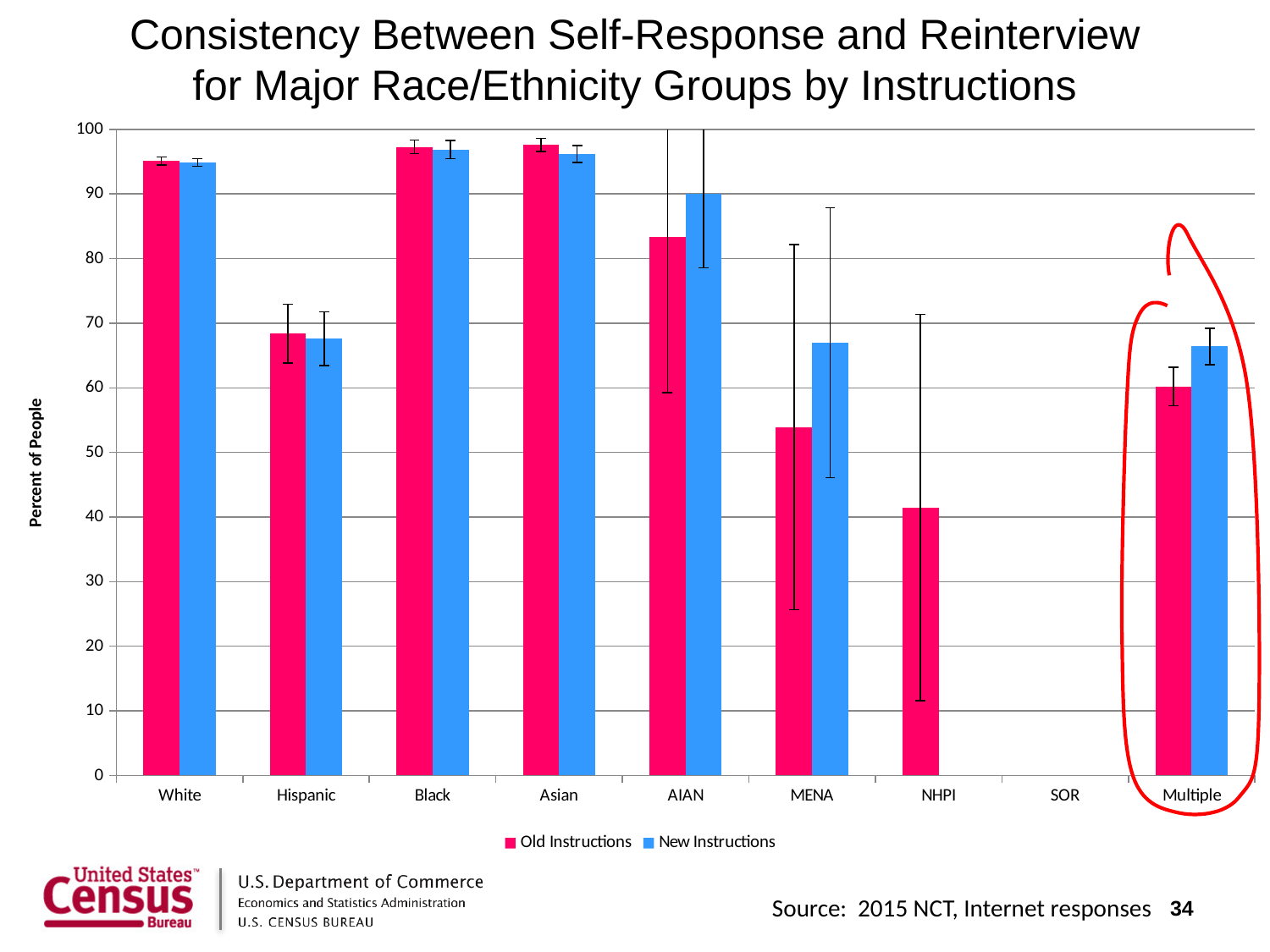
For AIAN, which is larger: the Old Instructions value or the New Instructions value? New Instructions Which category on the chart is circled in red? Multiple Is the Old Instructions value for Hispanic greater or less than 60? greater For Multiple, which is larger: the Old Instructions value or the New Instructions value? New Instructions Which category has the lowest Old Instructions value? NHPI Is the New Instructions value for AIAN greater or less than 80? greater What kind of chart is shown on the slide? bar chart How many series does the legend list? 2 Is the Old Instructions value for NHPI greater or less than 50? less What is the label on the y axis? Percent of People How many race/ethnicity categories are shown along the x axis? 9